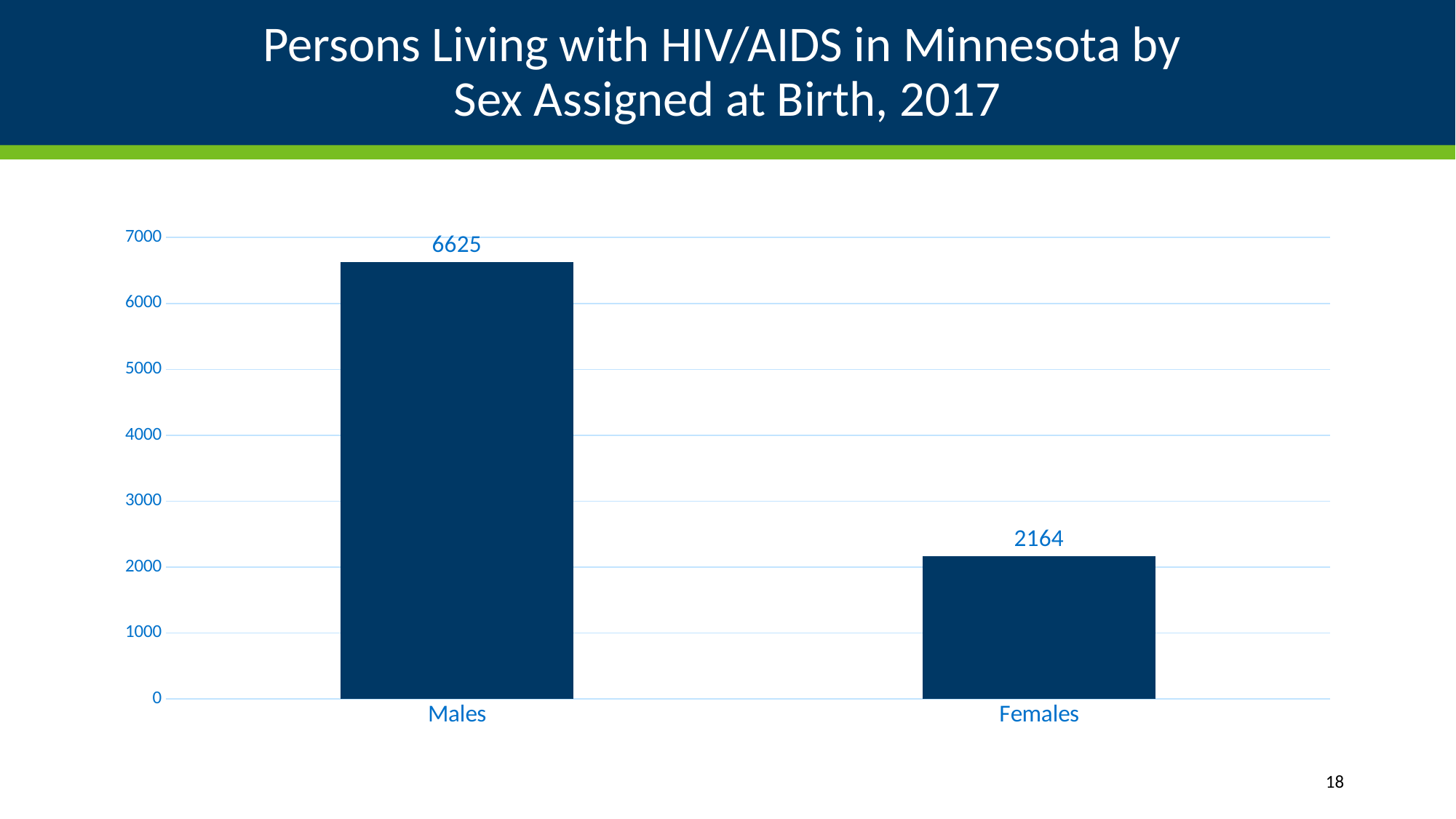
What is the title of the slide? Persons Living with HIV/AIDS in Minnesota by Sex Assigned at Birth, 2017 What is the difference between the values for Males and Females? 4461 What is the total of the values for Males and Females? 8789 What kind of chart is shown on the slide? bar chart What is the value for Males? 6625 Which is larger, the value for Males or the value for Females? Males Which category has the highest value? Males Is the value for Females greater or less than 3000? less Which category has the lowest value? Females How many categories are shown on the x axis? 2 What is the value for Females? 2164 Is the value for Males greater or less than 6000? greater